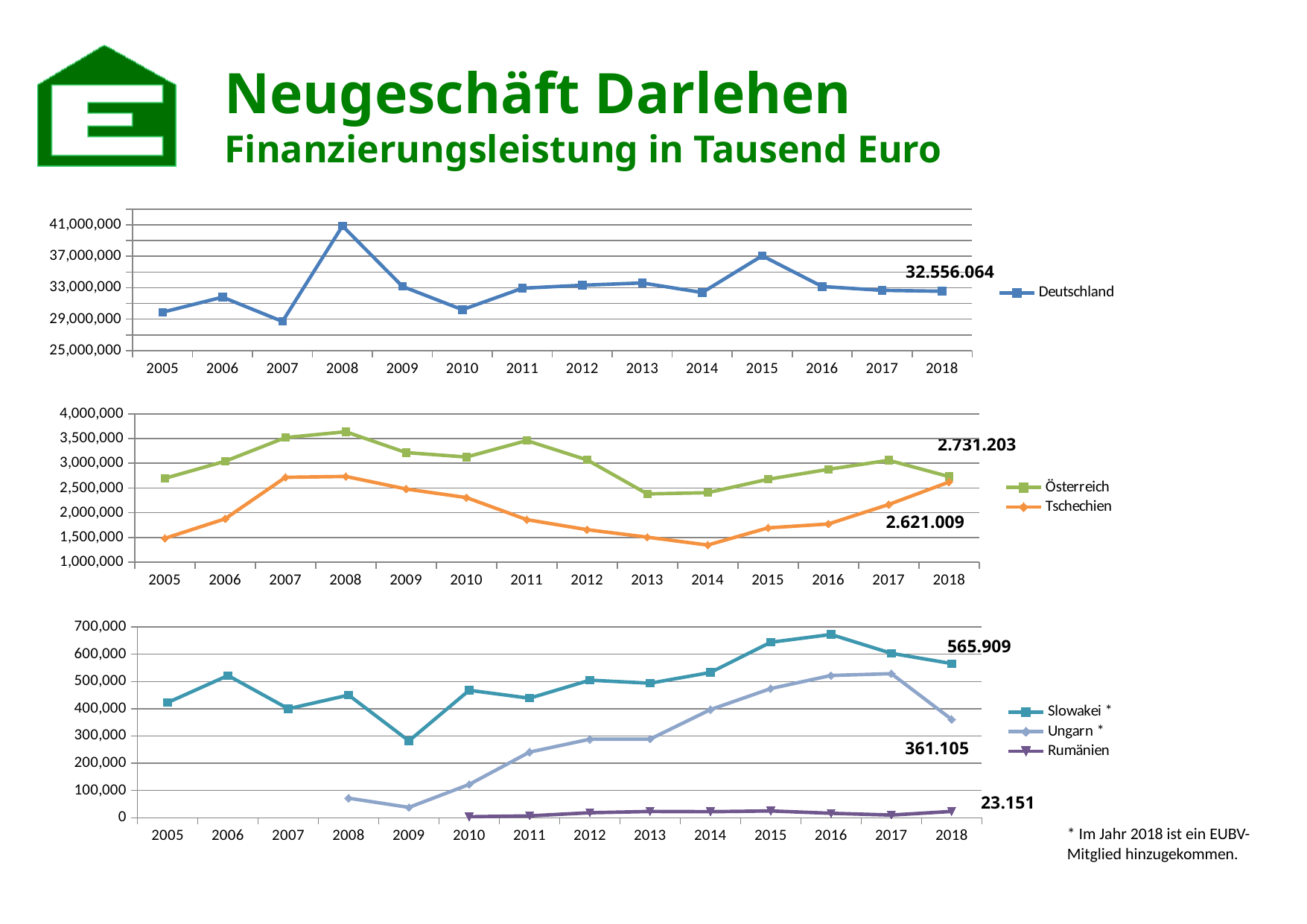
On the bottom chart, what is the value for Rumänien in 2018? 23.151 What kind of chart is the top chart? Line chart On the middle chart, what is the value for Tschechien in 2018? 2.621.009 On the top chart, what is the value for Deutschland in 2018? 32.556.064 On the bottom chart, is the value for Ungarn in 2008 greater or less than 100,000? less On the middle chart, what is the value for Österreich in 2018? 2.731.203 On the bottom chart, what is the difference between the 2018 values for Slowakei and Ungarn? 204.804 On the middle chart, which series has the larger value in 2018, Österreich or Tschechien? Österreich On the top chart, is the value for Deutschland in 2008 greater or less than 37,000,000? greater How many series does the legend of the bottom chart list? 3 On the top chart, in which year is the value for Deutschland highest? 2008 On the middle chart, in which year is the value for Tschechien lowest? 2014